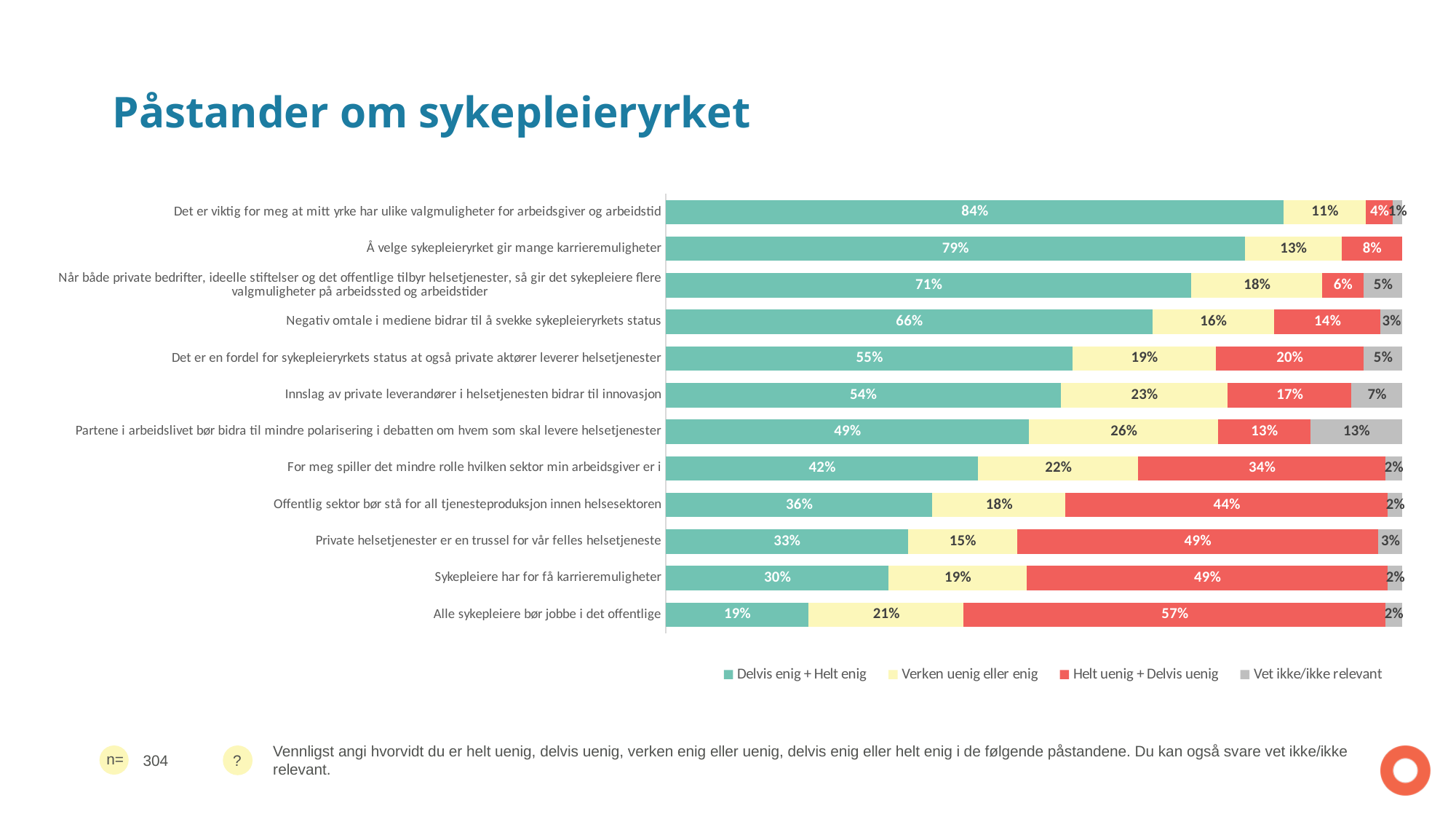
What is the difference between the "Delvis enig + Helt enig" values for "Å velge sykepleieryrket gir mange karrieremuligheter" and "Sykepleiere har for få karrieremuligheter"? 49 percentage points Which is larger: the "Helt uenig + Delvis uenig" value for "Negativ omtale i mediene bidrar til å svekke sykepleieryrkets status" or for "Det er en fordel for sykepleieryrkets status at også private aktører leverer helsetjenester"? Det er en fordel for sykepleieryrkets status at også private aktører leverer helsetjenester What is the "Vet ikke/ikke relevant" value for "Innslag av private leverandører i helsetjenesten bidrar til innovasjon"? 7% Which statement has the highest "Helt uenig + Delvis uenig" share? Alle sykepleiere bør jobbe i det offentlige What kind of chart is shown on the slide? Stacked bar chart What is the "Verken uenig eller enig" value for "Partene i arbeidslivet bør bidra til mindre polarisering i debatten om hvem som skal levere helsetjenester"? 26% How many series does the legend list? 4 What percentage of respondents answered "Delvis enig + Helt enig" to "Alle sykepleiere bør jobbe i det offentlige"? 19% Which statement has the highest "Delvis enig + Helt enig" share? Det er viktig for meg at mitt yrke har ulike valgmuligheter for arbeidsgiver og arbeidstid What is the "Helt uenig + Delvis uenig" value for "Offentlig sektor bør stå for all tjenesteproduksjon innen helsesektoren"? 44% How many statements are shown in the chart? 12 Which statement has the lowest "Delvis enig + Helt enig" share? Alle sykepleiere bør jobbe i det offentlige